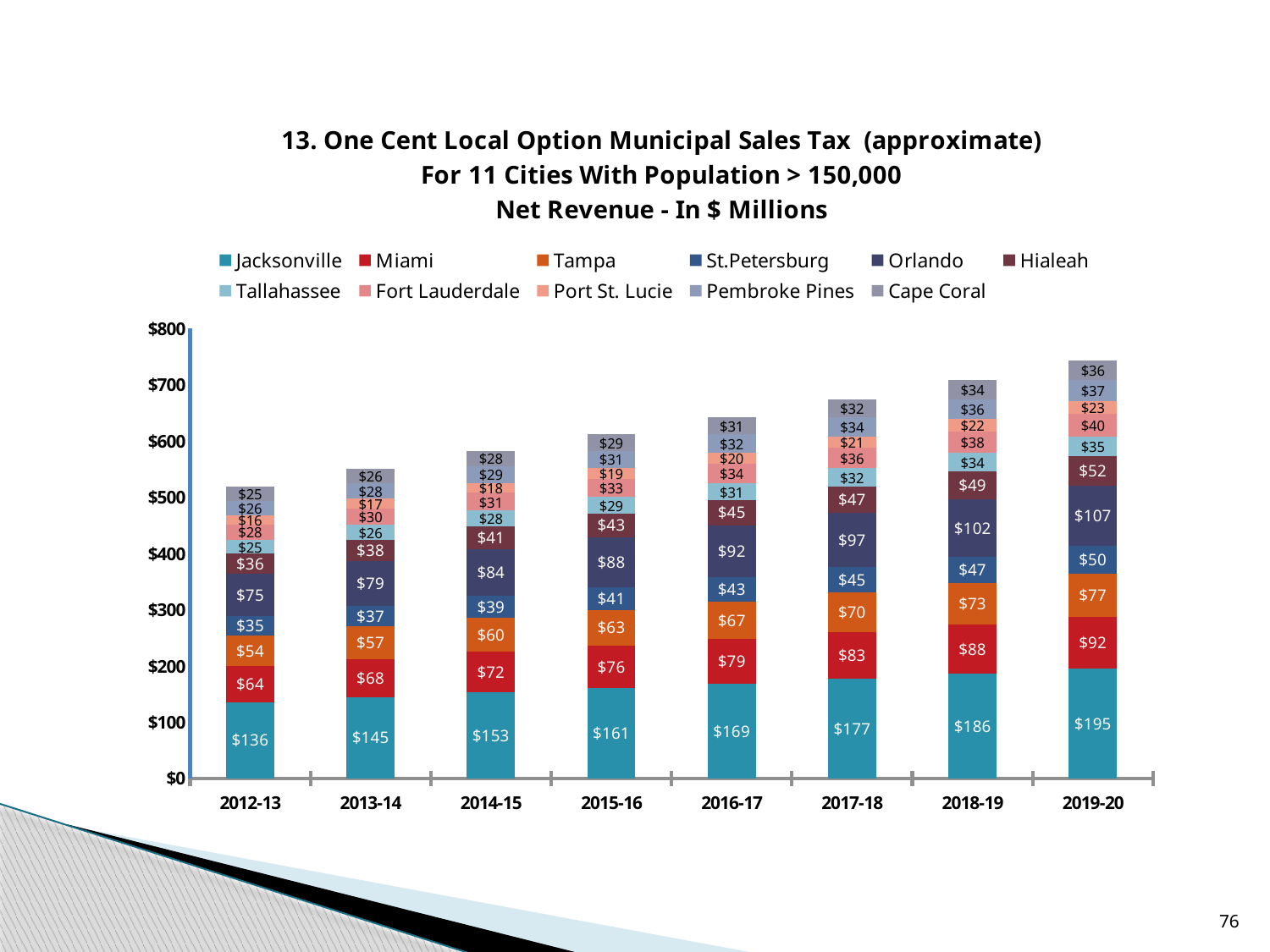
In 2017-18, which is larger: the Orlando value or the Miami value? Orlando How many cities does the legend list? 11 What kind of chart is shown on the slide? stacked bar chart What is the value for Orlando in 2018-19? $102 How many fiscal years are shown on the x axis? 8 Is the total stacked bar for 2012-13 greater or less than $600? less What is the difference between the Jacksonville values for 2019-20 and 2012-13? $59 What is the value for Jacksonville in 2019-20? $195 What is the value for Miami in 2015-16? $76 Does the Jacksonville value rise or fall from 2012-13 to 2019-20? rise In which year is the Jacksonville value lowest? 2012-13 In which year is the Jacksonville value highest? 2019-20